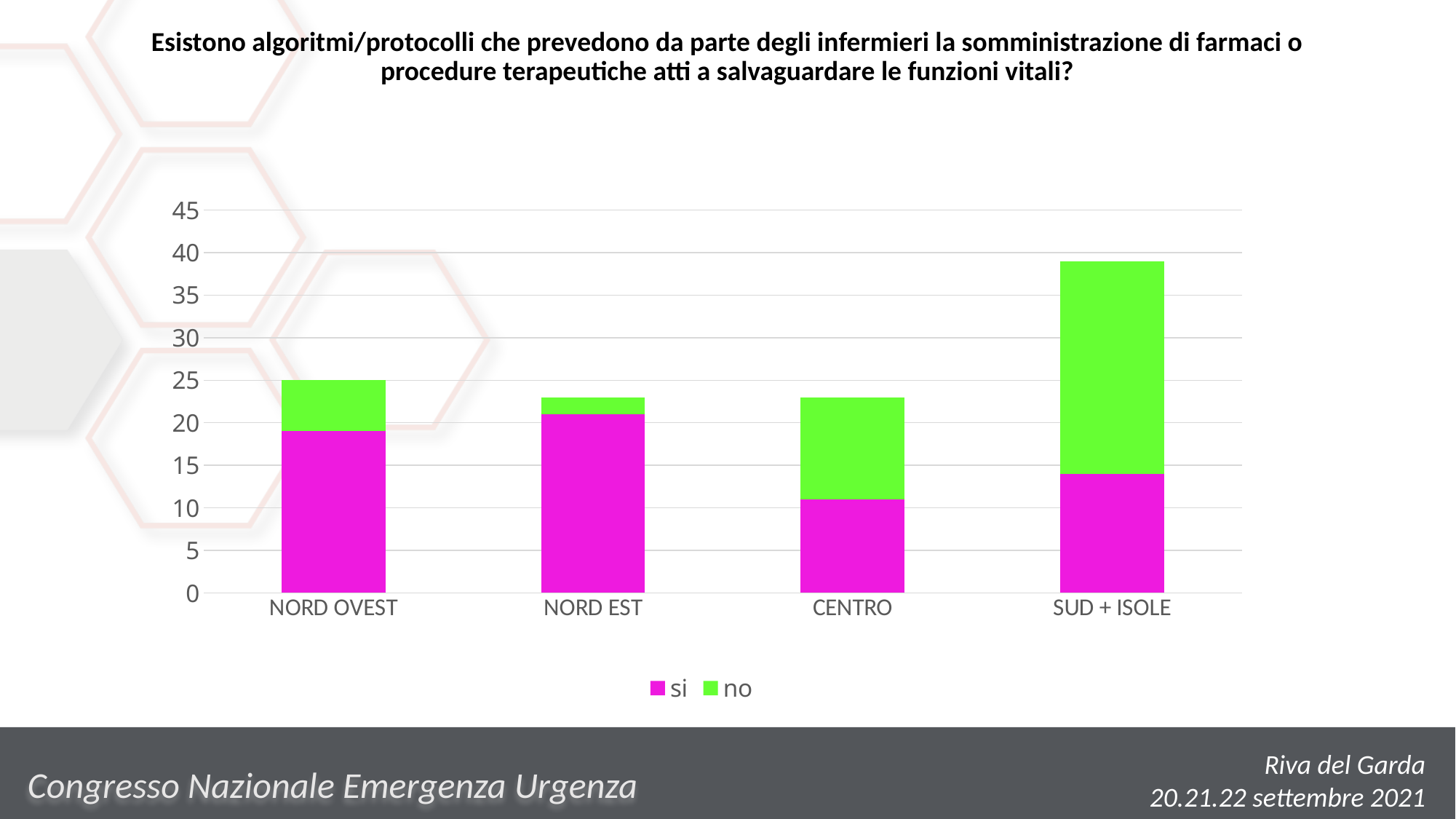
Is the total stacked value for NORD OVEST greater or less than 30? less Which category has the smallest 'no' segment? NORD EST Is the total stacked value for SUD + ISOLE greater or less than 35? greater How many series does the legend list? 2 For SUD + ISOLE, which is larger, the 'si' segment or the 'no' segment? no Which category has the tallest stacked bar overall? SUD + ISOLE Which colour represents the 'si' series in the chart? magenta Which category has the smallest 'si' segment? CENTRO Is the 'si' value for CENTRO greater or less than 15? less What kind of chart is shown on the slide? stacked bar chart How many categories are shown on the x axis of the chart? 4 Which category has the largest 'no' segment? SUD + ISOLE